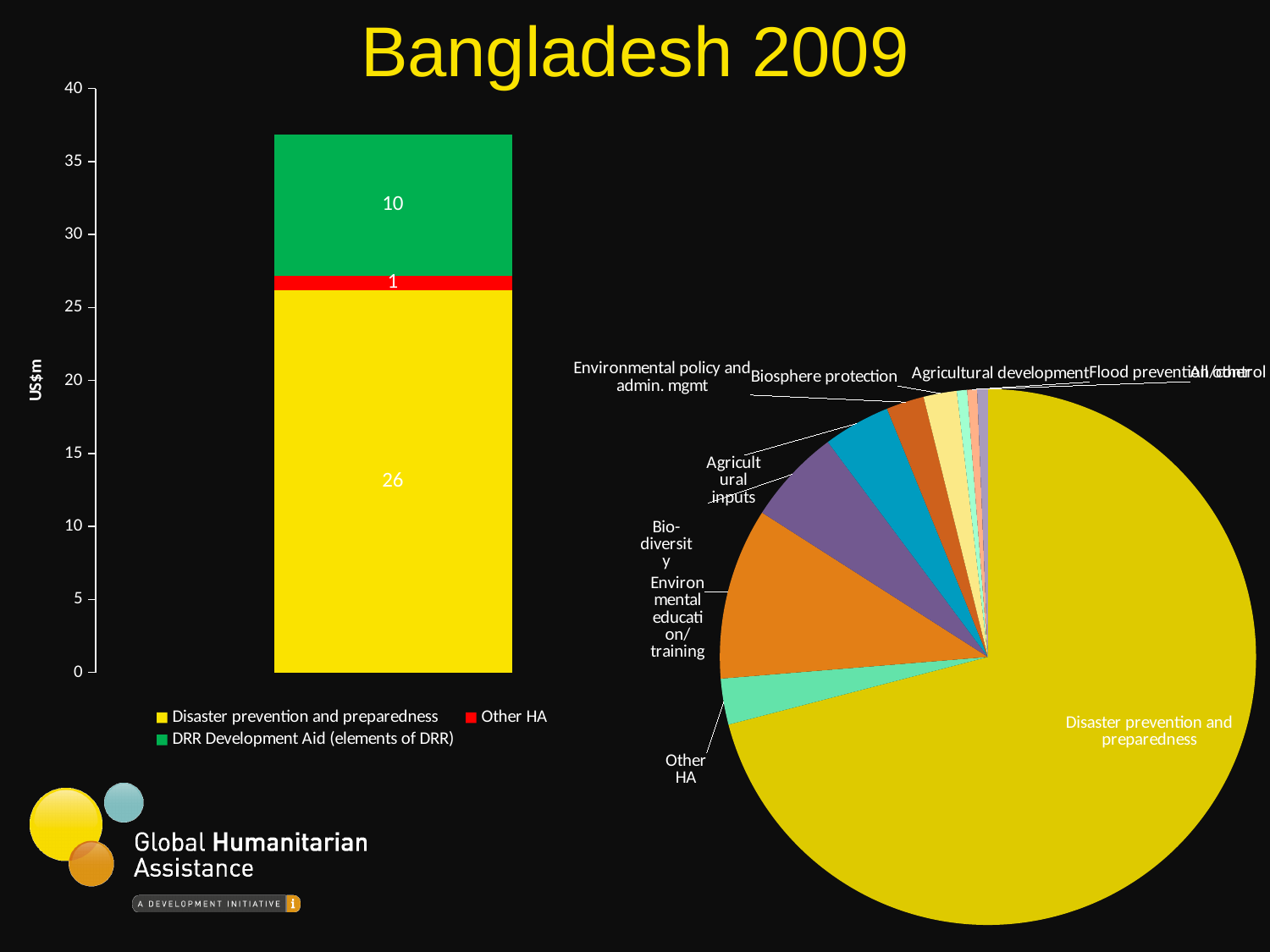
What kind of chart is shown on the left of the slide? Stacked bar chart In the stacked bar chart on the left, which is larger: DRR Development Aid (elements of DRR) or Other HA? DRR Development Aid (elements of DRR) In the stacked bar chart on the left, which segment has the smallest value? Other HA In the stacked bar chart on the left, what is the value for Disaster prevention and preparedness? 26 In the stacked bar chart on the left, what is the difference between the Disaster prevention and preparedness value and the DRR Development Aid value? 16 In the stacked bar chart on the left, what is the value for Other HA? 1 What kind of chart is shown on the right of the slide? Pie chart In the stacked bar chart on the left, how many series does the legend list? 3 In the stacked bar chart on the left, what unit is shown on the vertical axis? US$m In the stacked bar chart on the left, what is the total of the stacked bar? 37 In the stacked bar chart on the left, what is the value for DRR Development Aid (elements of DRR)? 10 In the pie chart on the right, which slice is the largest? Disaster prevention and preparedness